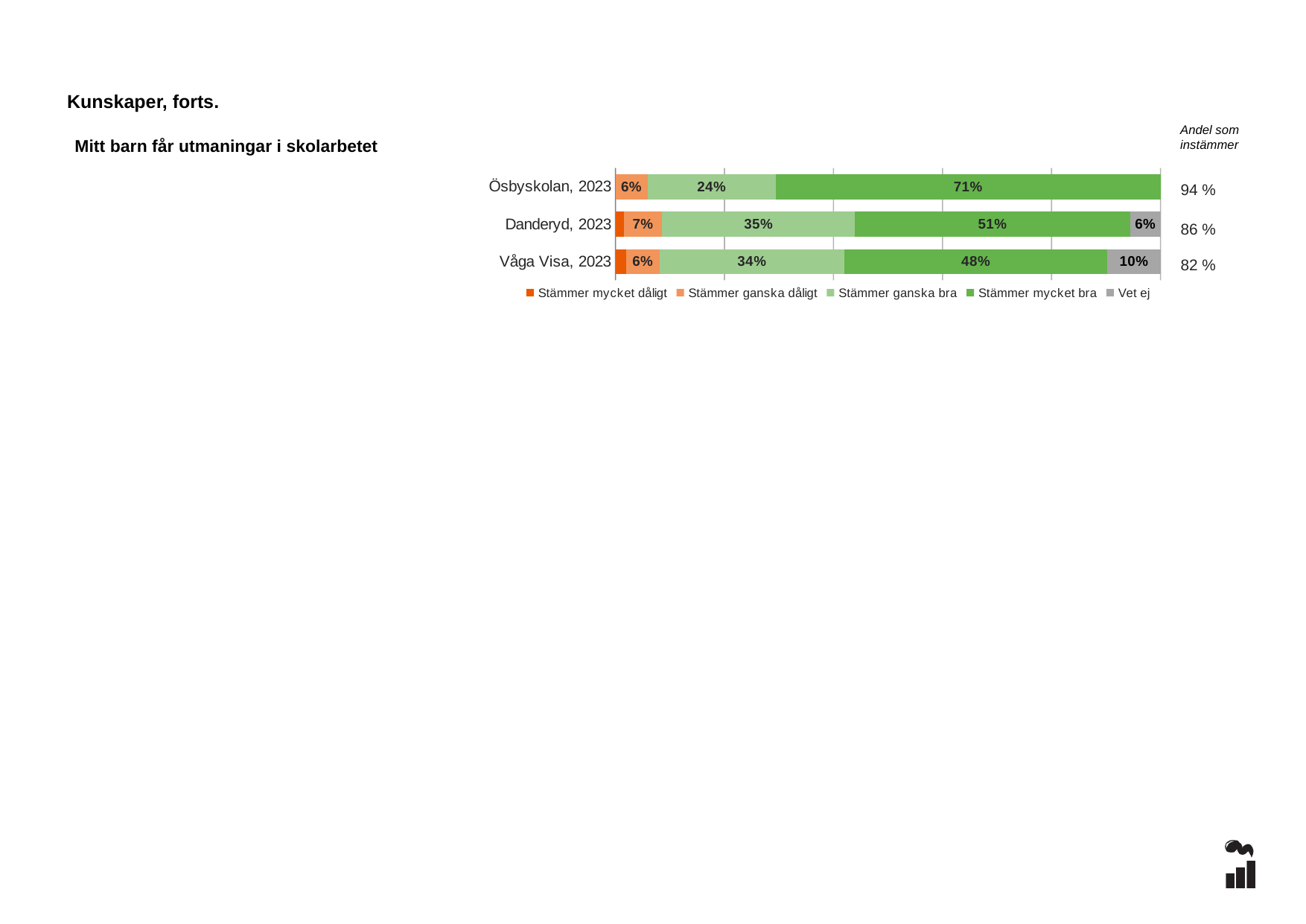
What is the value for "Stämmer mycket bra" for Ösbyskolan, 2023? 71% Which is larger: the "Vet ej" value for Danderyd, 2023 or for Våga Visa, 2023? Våga Visa, 2023 What is the "Andel som instämmer" figure shown for Ösbyskolan, 2023? 94 % How many series does the legend list? 5 What is the difference between the "Stämmer mycket bra" values for Ösbyskolan, 2023 and Danderyd, 2023? 20 percentage points How many categories (bars) are shown in the chart? 3 What kind of chart is shown on the slide? Stacked bar chart Which category has the highest value for "Stämmer mycket bra"? Ösbyskolan, 2023 What is the value for "Stämmer ganska dåligt" for Danderyd, 2023? 7% What is the value for "Stämmer ganska bra" for Danderyd, 2023? 35% What is the value for "Vet ej" for Våga Visa, 2023? 10% Which category has the lowest value for "Stämmer ganska bra"? Ösbyskolan, 2023